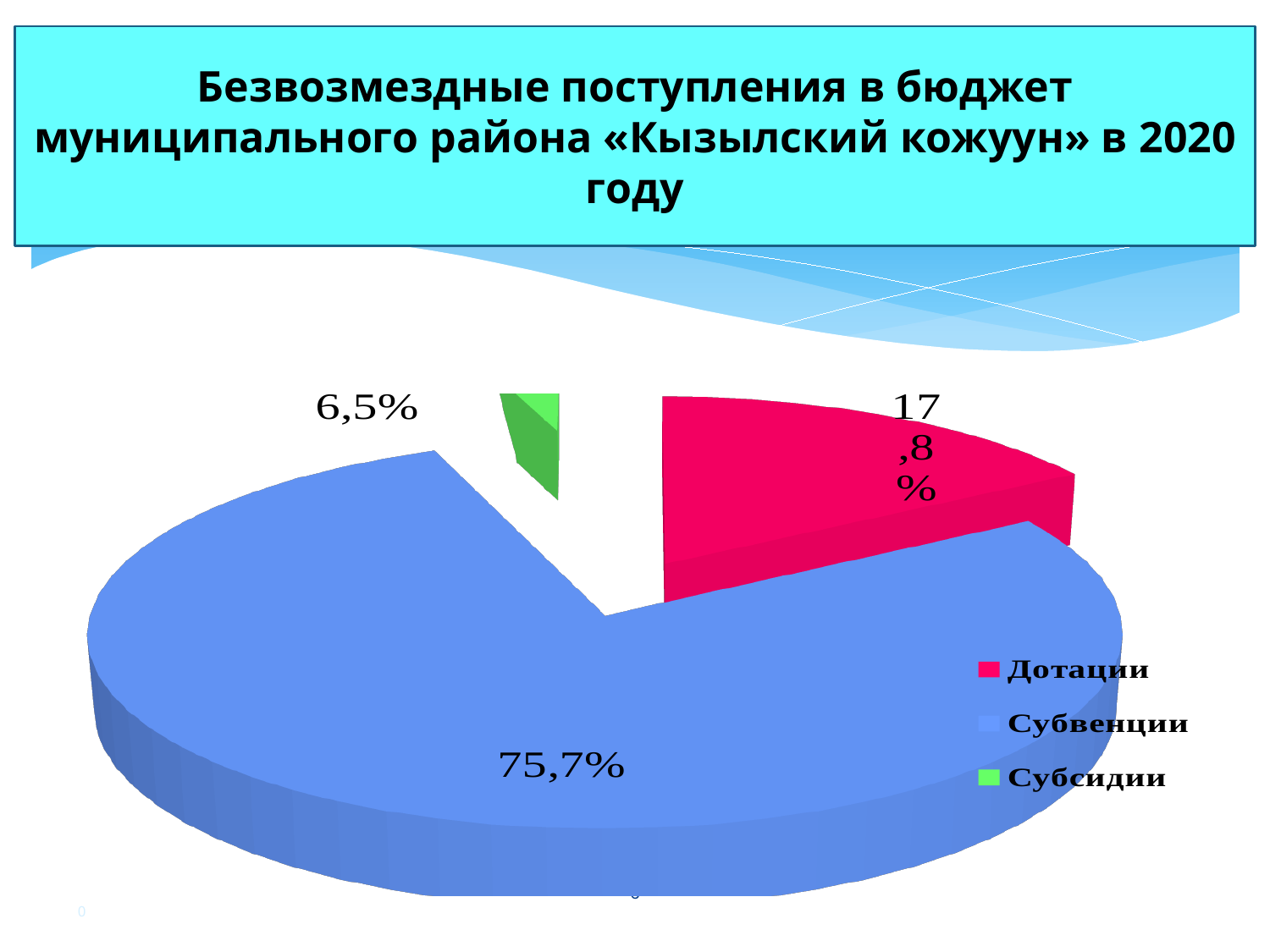
What share of the pie does Субсидии have? 6,5% Which category has the largest slice of the pie? Субвенции What share of the pie does Субвенции have? 75,7% How many entries does the legend list? 3 Which is larger, the share for Дотации or the share for Субсидии? Дотации What colour is the Субсидии slice in the pie chart? green What is the difference in percentage points between the Субвенции share and the Дотации share? 57,9 What share of the pie does Дотации have? 17,8% Which category has the smallest slice of the pie? Субсидии What kind of chart is shown on the slide? pie chart How many slices does the pie chart have? 3 Which legend entry is shown in red? Дотации